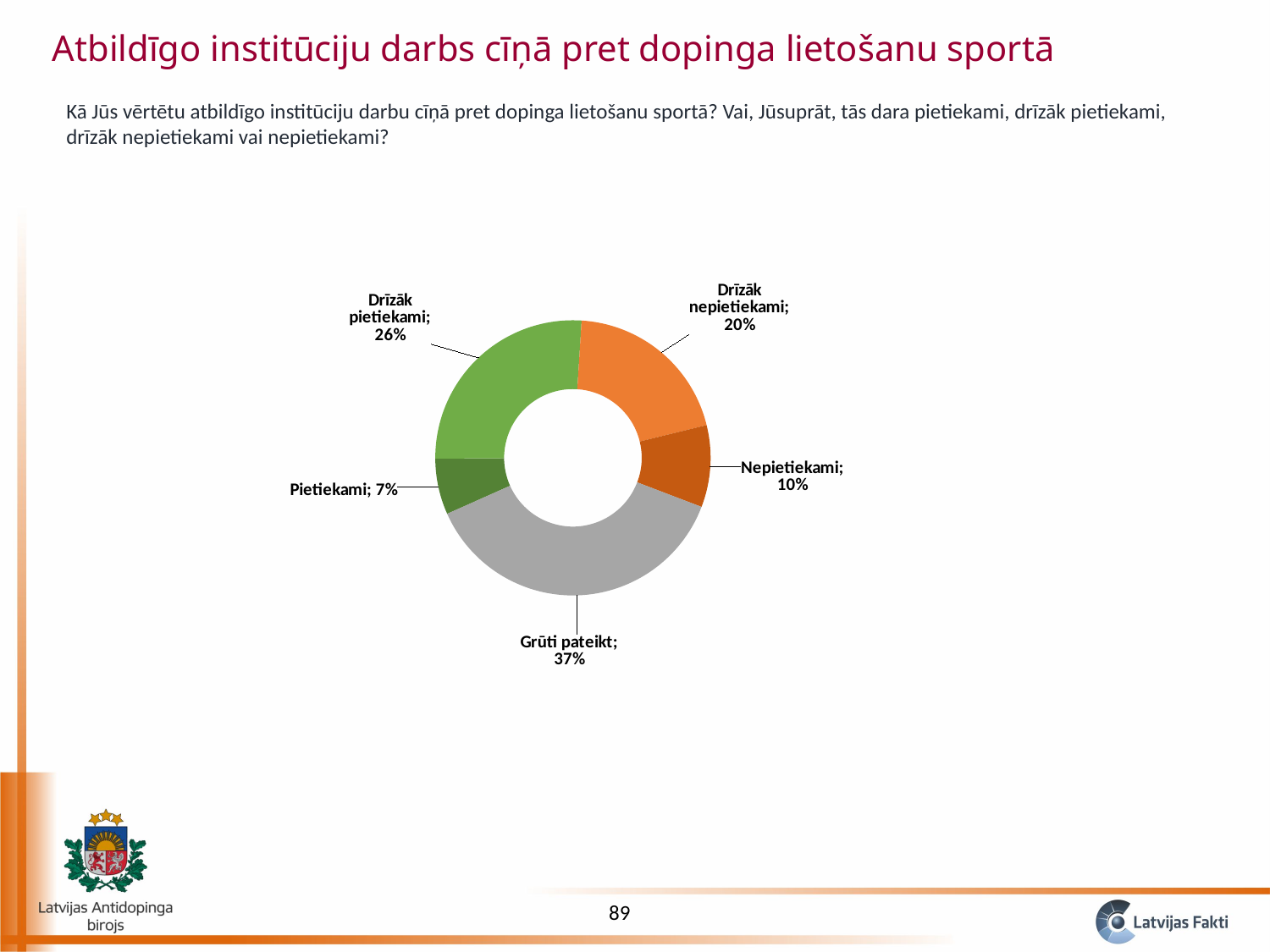
What share of respondents answered "Pietiekami"? 7% Which is larger, the share for "Nepietiekami" or the share for "Pietiekami"? Nepietiekami What share of respondents answered "Drīzāk pietiekami"? 26% How many response categories are shown in the chart? 5 What share of respondents answered "Grūti pateikt"? 37% What is the difference in percentage points between "Drīzāk pietiekami" and "Drīzāk nepietiekami"? 6 percentage points Which response category has the largest share? Grūti pateikt What kind of chart is shown on the slide? Doughnut (pie) chart What share of respondents answered "Nepietiekami"? 10% What share of respondents answered "Drīzāk nepietiekami"? 20% Which response category has the smallest share? Pietiekami What is the combined share of "Pietiekami" and "Drīzāk pietiekami"? 33%